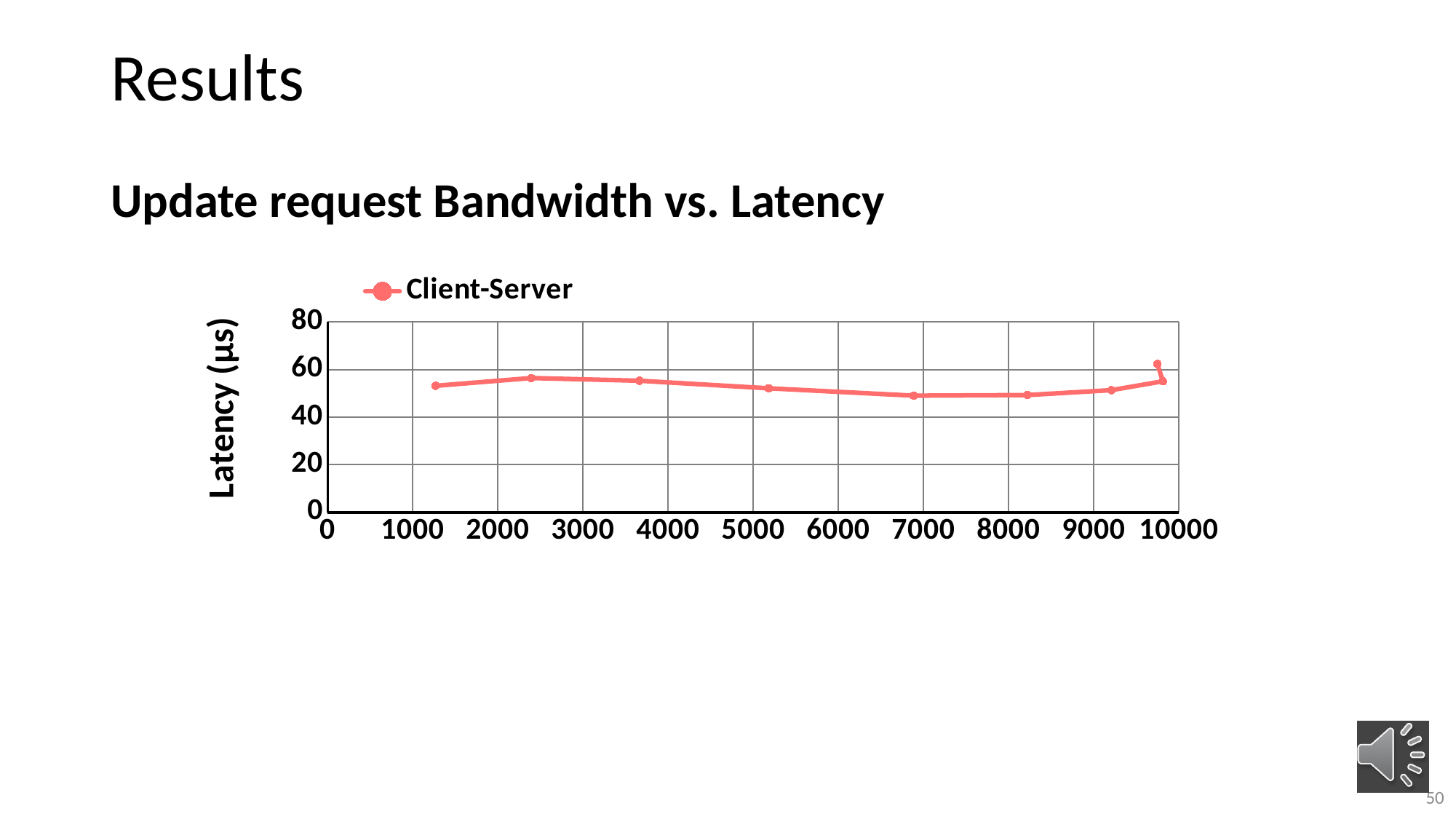
Is the latency value at a bandwidth of about 5200 greater or less than 40? greater How many series does the legend list? 1 What is the label of the y axis? Latency (µs) Are all plotted latency values greater or less than 80? less Is the latency value at a bandwidth of about 8200 greater or less than 60? less What kind of chart is shown on the slide? line chart What is the highest value shown on the y axis? 80 What is the name of the series shown in the legend? Client-Server Which is larger, the latency at a bandwidth of about 2400 or the latency at a bandwidth of about 7000? about 2400